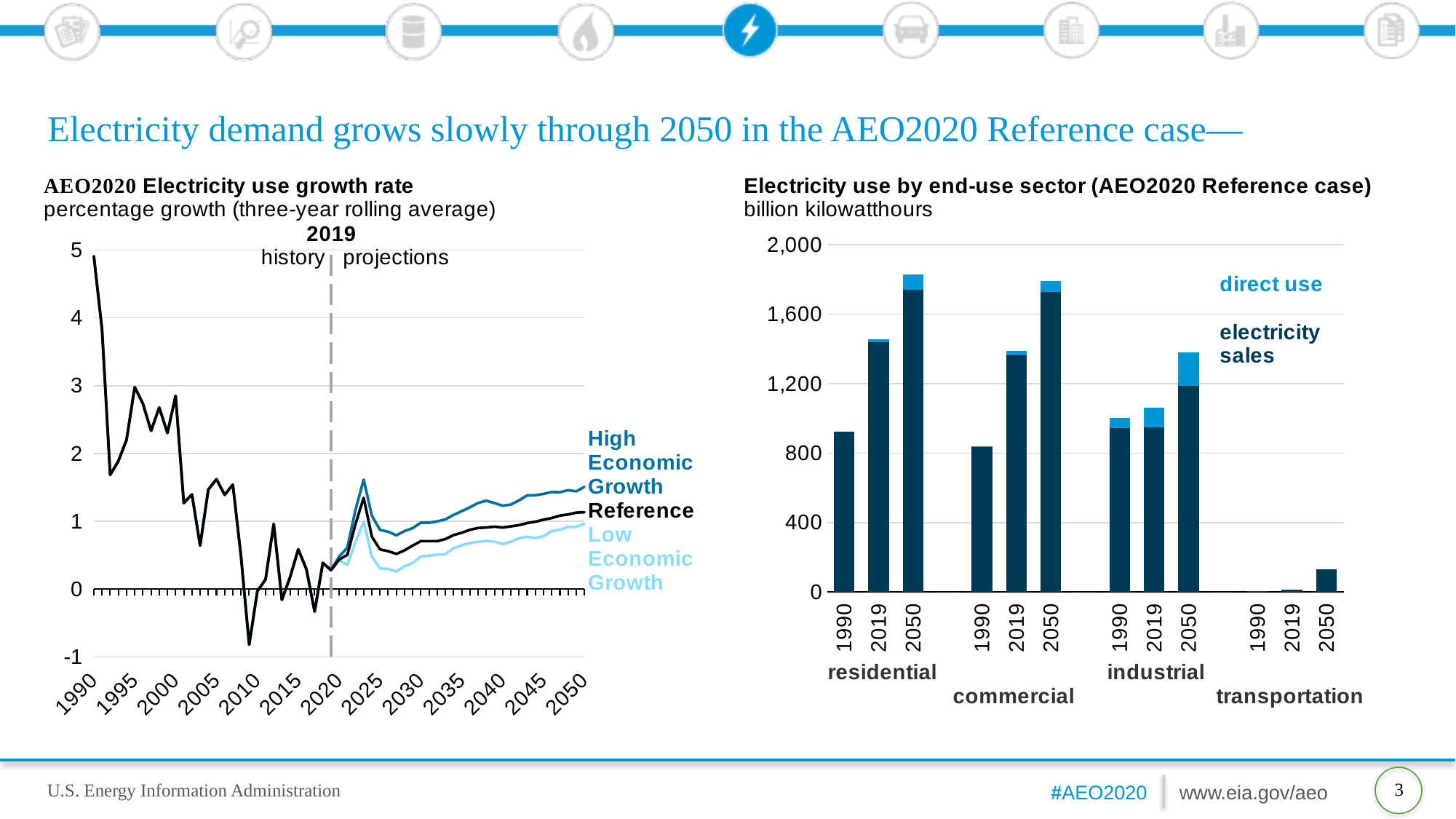
On the right chart (Electricity use by end-use sector), what kind of chart is shown? stacked bar chart On the right chart (Electricity use by end-use sector), which sector has the lowest electricity use in every year shown? transportation On the left chart (AEO2020 Electricity use growth rate), which series is highest in 2050? High Economic Growth On the left chart (AEO2020 Electricity use growth rate), which series is lowest in 2050? Low Economic Growth On the left chart (AEO2020 Electricity use growth rate), what kind of chart is shown? line chart On the left chart (AEO2020 Electricity use growth rate), is the growth rate in 1990 greater or less than 4? greater On the left chart (AEO2020 Electricity use growth rate), how many series are labelled? 3 On the left chart (AEO2020 Electricity use growth rate), do the projected growth rates rise or fall from 2030 to 2050? rise On the right chart (Electricity use by end-use sector), how many bars are plotted? 12 On the right chart (Electricity use by end-use sector), how many series does the legend list? 2 On the right chart (Electricity use by end-use sector), is the total for residential in 2050 greater or less than 1,600? greater On the left chart (AEO2020 Electricity use growth rate), what year separates history from projections? 2019